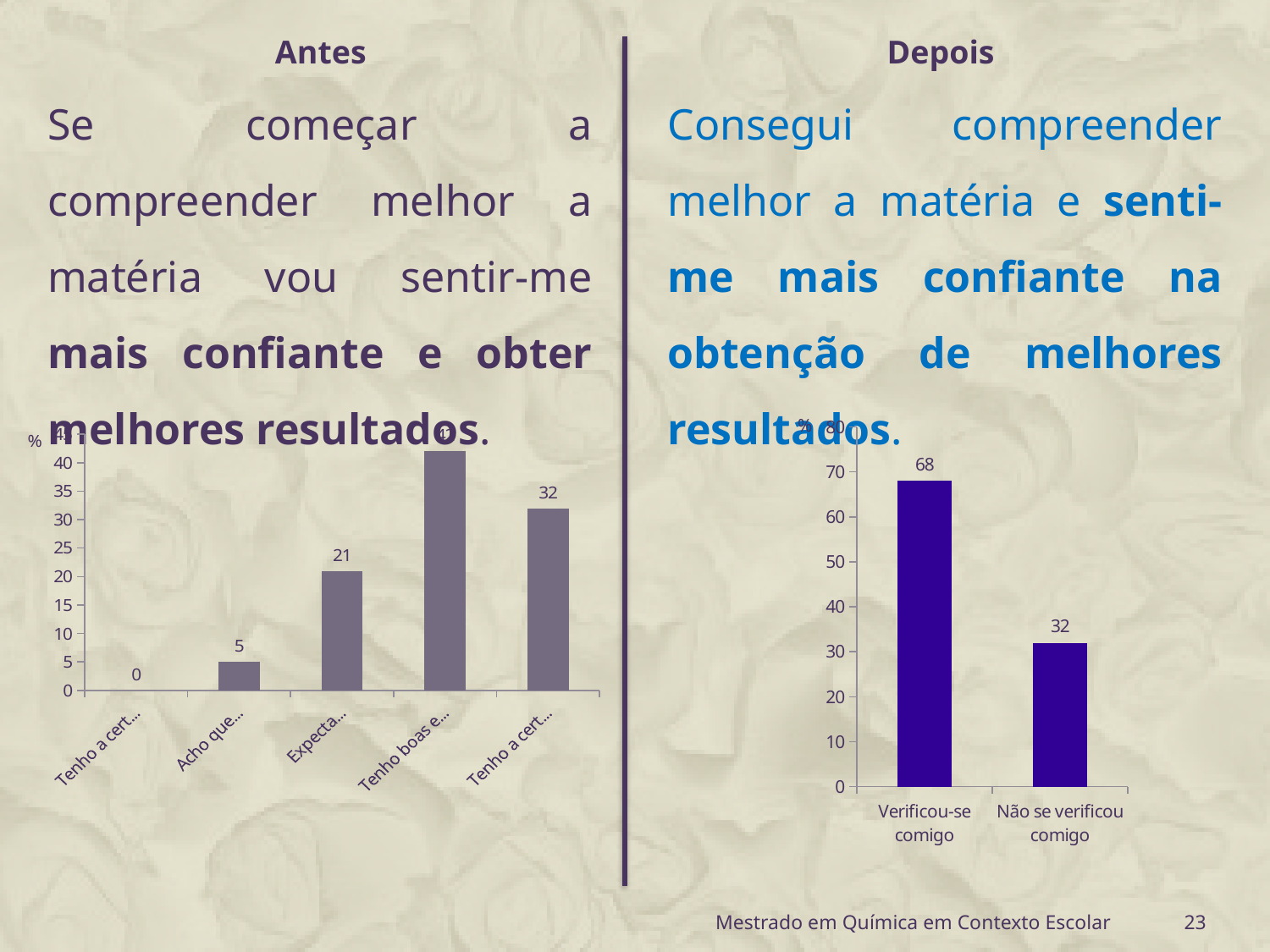
How many categories are shown in the chart on the right (Depois)? 2 In the chart on the right (Depois), what is the value for "Verificou-se comigo"? 68 In the chart on the left (Antes), what is the difference between "Expecta..." and "Acho que..."? 16 In the chart on the left (Antes), what is the value for "Acho que..."? 5 In the chart on the left (Antes), what is the value for "Expecta..."? 21 In the chart on the left (Antes), what is the value of the rightmost bar? 32 In the chart on the right (Depois), what is the value for "Não se verificou comigo"? 32 In the chart on the right (Depois), which category has the higher value? Verificou-se comigo In the chart on the right (Depois), what is the difference between "Verificou-se comigo" and "Não se verificou comigo"? 36 What kind of chart is shown on the right (Depois)? Bar chart In the chart on the left (Antes), is the value for "Tenho boas e..." greater or less than 40? greater How many bars are shown in the chart on the left (Antes)? 5